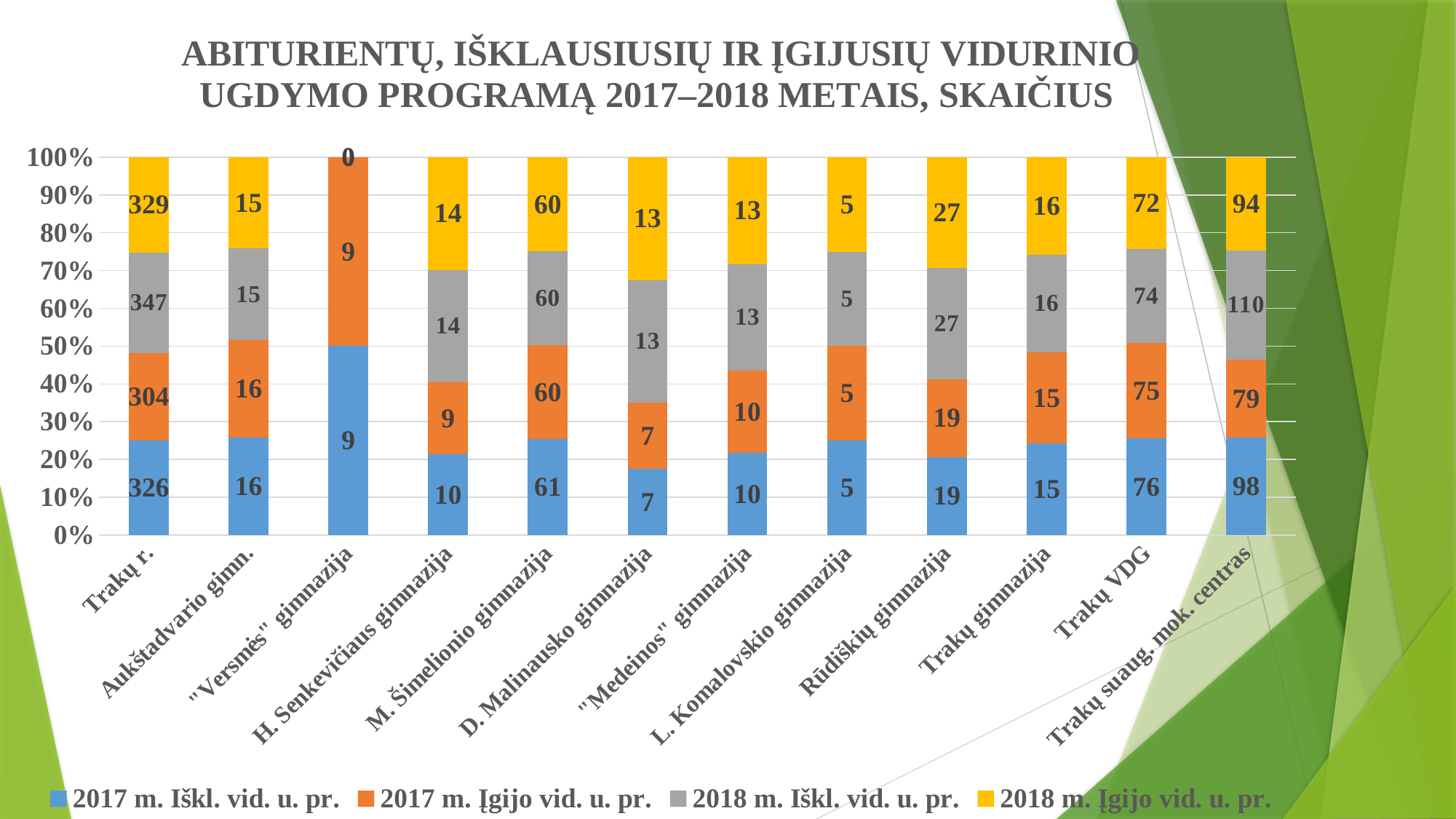
What is the difference between "2018 m. Iškl. vid. u. pr." and "2018 m. Įgijo vid. u. pr." for Trakų suaug. mok. centras? 16 Which is larger for M. Šimelionio gimnazija: "2017 m. Iškl. vid. u. pr." or "2017 m. Įgijo vid. u. pr."? 2017 m. Iškl. vid. u. pr. How many series does the legend list? 4 What is the value of "2018 m. Įgijo vid. u. pr." for Trakų suaug. mok. centras? 94 Which colour represents "2018 m. Įgijo vid. u. pr." in the legend? yellow What is the value of "2017 m. Iškl. vid. u. pr." for Trakų r.? 326 How many schools (categories) are shown on the x axis? 12 Which school has the lowest value for "2017 m. Iškl. vid. u. pr."? L. Komalovskio gimnazija What kind of chart is shown on the slide? stacked bar chart What is the value of "2017 m. Įgijo vid. u. pr." for Trakų VDG? 75 What is the value of "2018 m. Iškl. vid. u. pr." for Rūdiškių gimnazija? 27 Which school has the highest value for "2018 m. Įgijo vid. u. pr."? Trakų r.